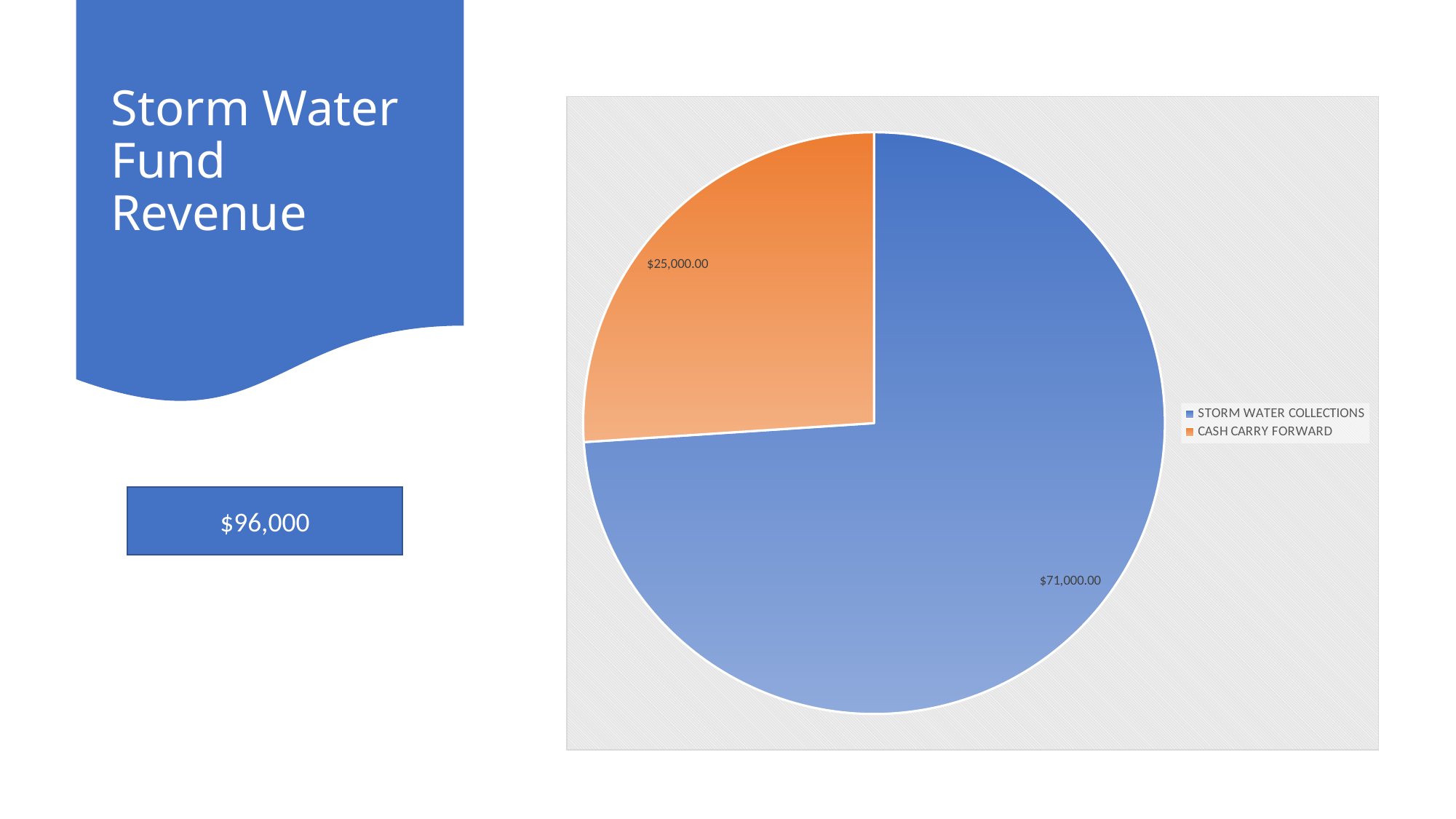
What is the total of the two slices in the pie chart? $96,000.00 What is the difference between STORM WATER COLLECTIONS and CASH CARRY FORWARD? $46,000.00 Which category has the smallest slice of the pie? CASH CARRY FORWARD How many entries does the legend list? 2 What colour is the CASH CARRY FORWARD slice? orange What is the value for CASH CARRY FORWARD? $25,000.00 What is the value for STORM WATER COLLECTIONS? $71,000.00 Which is larger, STORM WATER COLLECTIONS or CASH CARRY FORWARD? STORM WATER COLLECTIONS Which category has the largest slice of the pie? STORM WATER COLLECTIONS What colour is the STORM WATER COLLECTIONS slice? blue How many slices does the pie chart have? 2 What type of chart is shown on the slide? pie chart